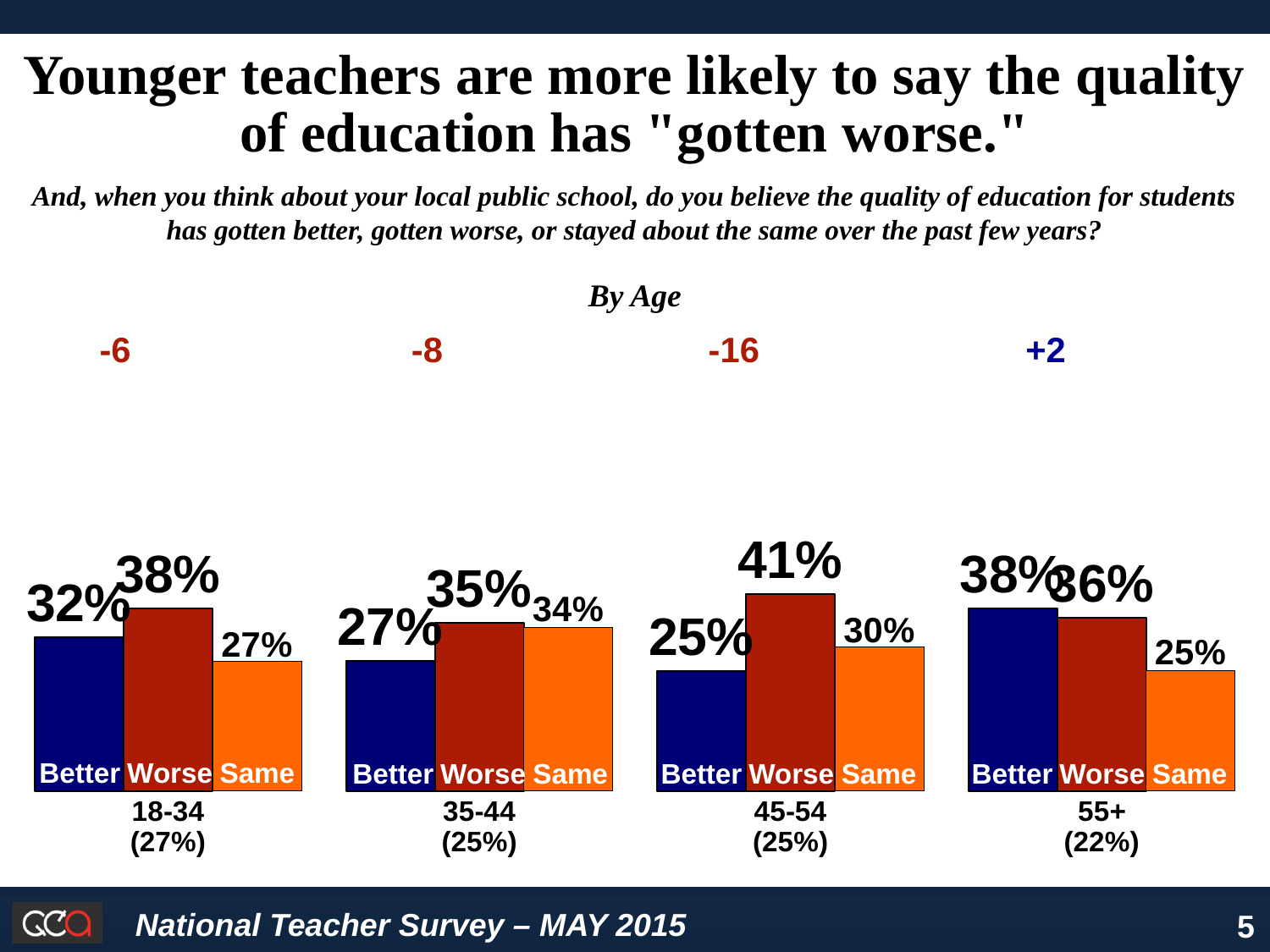
In the 55+ chart, what is the value for Same? 25% In the 18-34 chart, what is the difference between the Worse and Same values? 11 In the 45-54 chart, what is the value for Better? 25% In the 35-44 chart, what is the value for Same? 34% In the 18-34 chart, what percentage said the quality of education has gotten worse? 38% How many bars are in the 55+ chart? 3 How many age-group charts are shown on the slide? 4 In the 18-34 chart, which response has the lowest value? Same In the 35-44 chart, which is larger, Better or Same? Same What kind of chart is used for each age group on this slide? Bar chart In the 45-54 chart, what is the difference between the Worse and Better values? 16 In the 45-54 chart, which response has the highest value? Worse